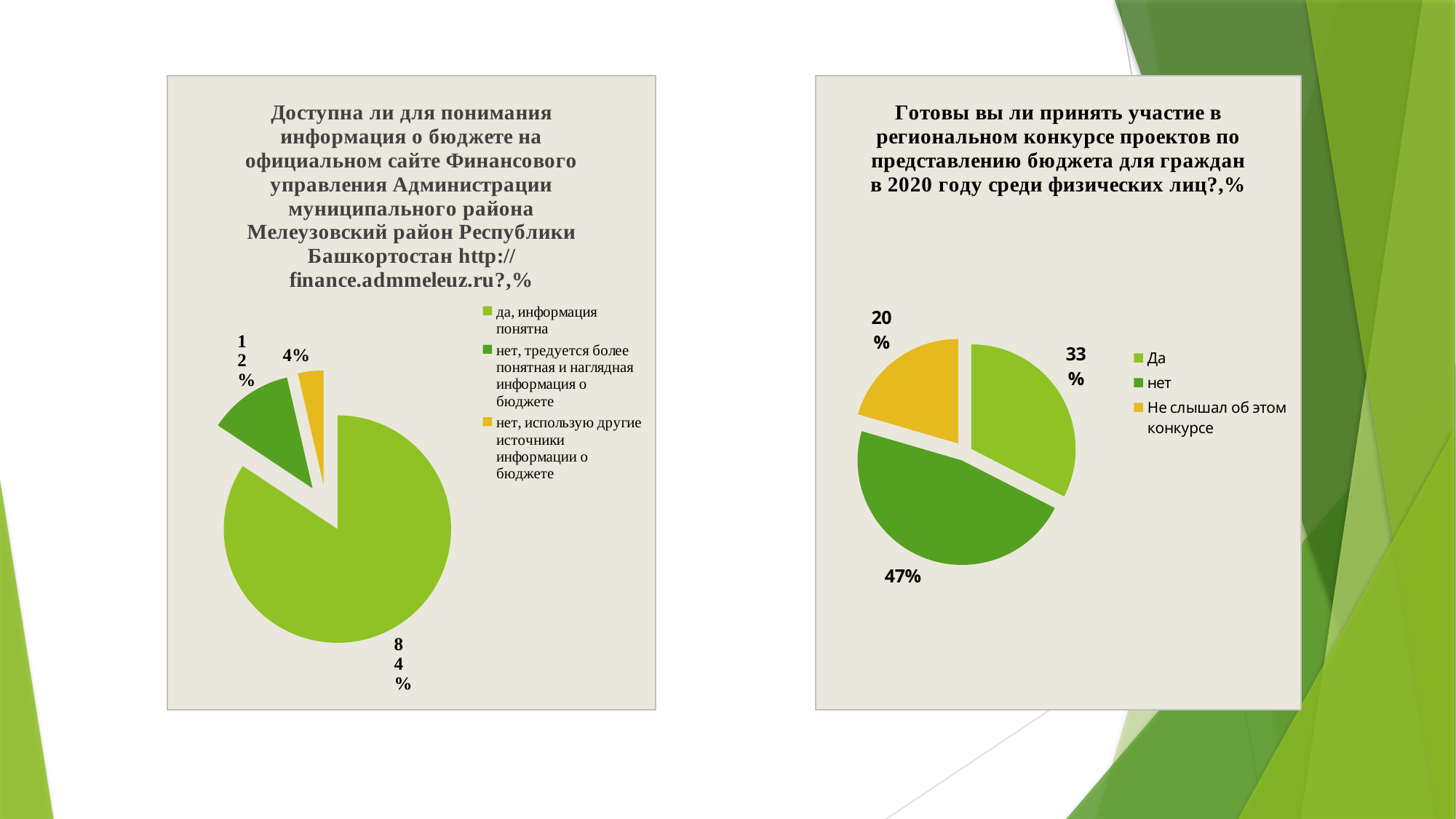
In the left chart, what is the difference between the "да, информация понятна" share and the 12% share? 72% In the left chart, what share of respondents answered "нет, использую другие источники информации о бюджете"? 4% In the right chart, which is larger: the share for "Да" or the share for "нет"? нет What type of chart is the right chart? Pie chart In the right chart, what share of respondents answered "Не слышал об этом конкурсе"? 20% In the right chart, what is the difference between the "нет" share and the "Да" share? 14% In the left chart, which answer has the largest share? да, информация понятна In the left chart, what share of respondents answered "да, информация понятна"? 84% In the right chart, which answer has the smallest share? Не слышал об этом конкурсе In the right chart, what share of respondents answered "Да"? 33% In the left chart, what share of respondents answered "нет, требуется более понятная и наглядная информация о бюджете"? 12% In the right chart, what share of respondents answered "нет"? 47%